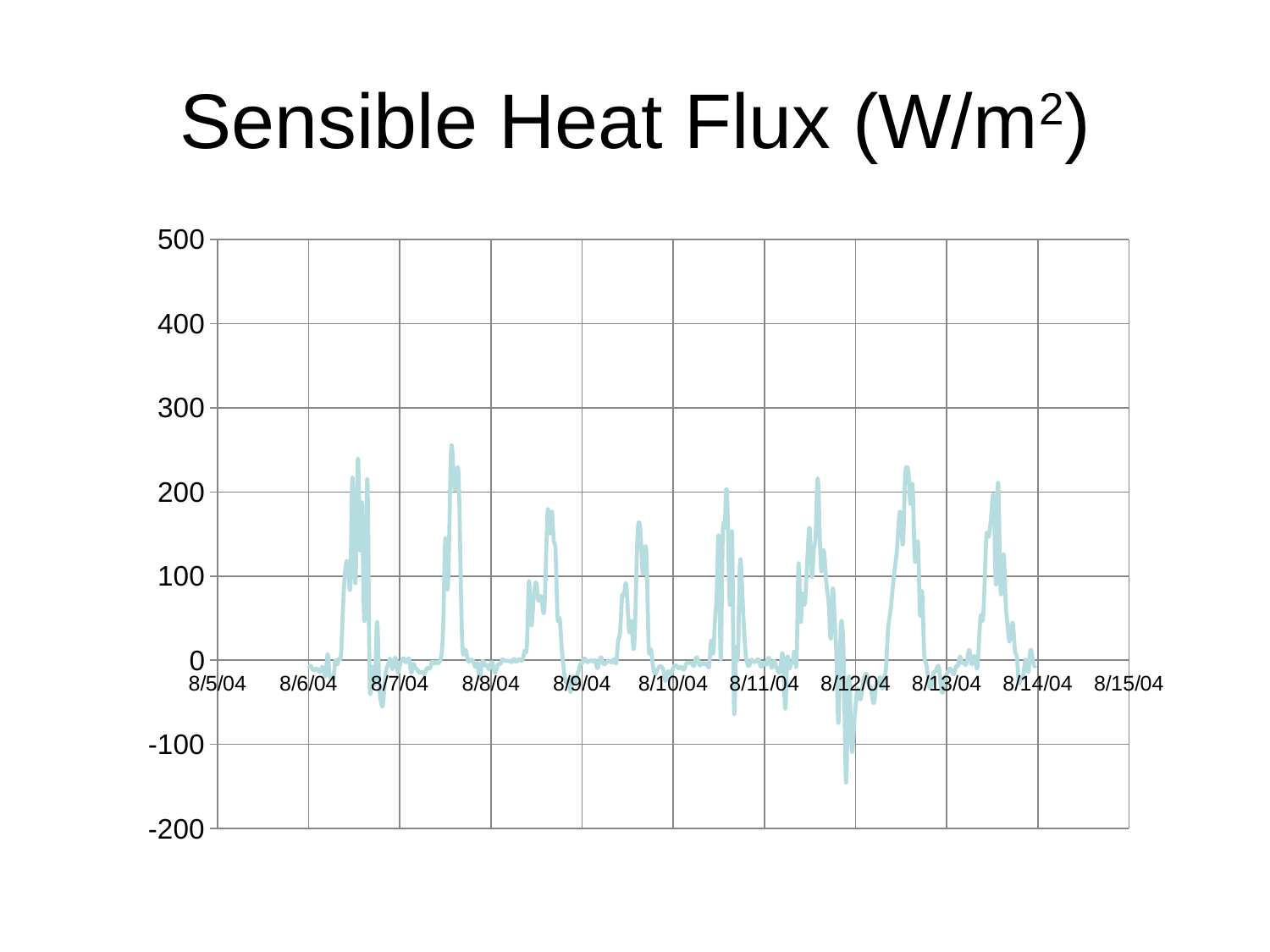
How many date labels are shown along the x axis? 11 Is the highest peak of the line greater or less than 300? less Is the peak of the line between 8/7/04 and 8/8/04 greater or less than 200? greater Is the peak of the line between 8/8/04 and 8/9/04 greater or less than 100? greater What is the title of the chart? Sensible Heat Flux (W/m2) What is the first date label on the x axis? 8/5/04 What kind of chart is shown on the slide? line chart What is the highest value shown on the y axis? 500 Which is higher: the peak between 8/7/04 and 8/8/04 or the peak between 8/9/04 and 8/10/04? the peak between 8/7/04 and 8/8/04